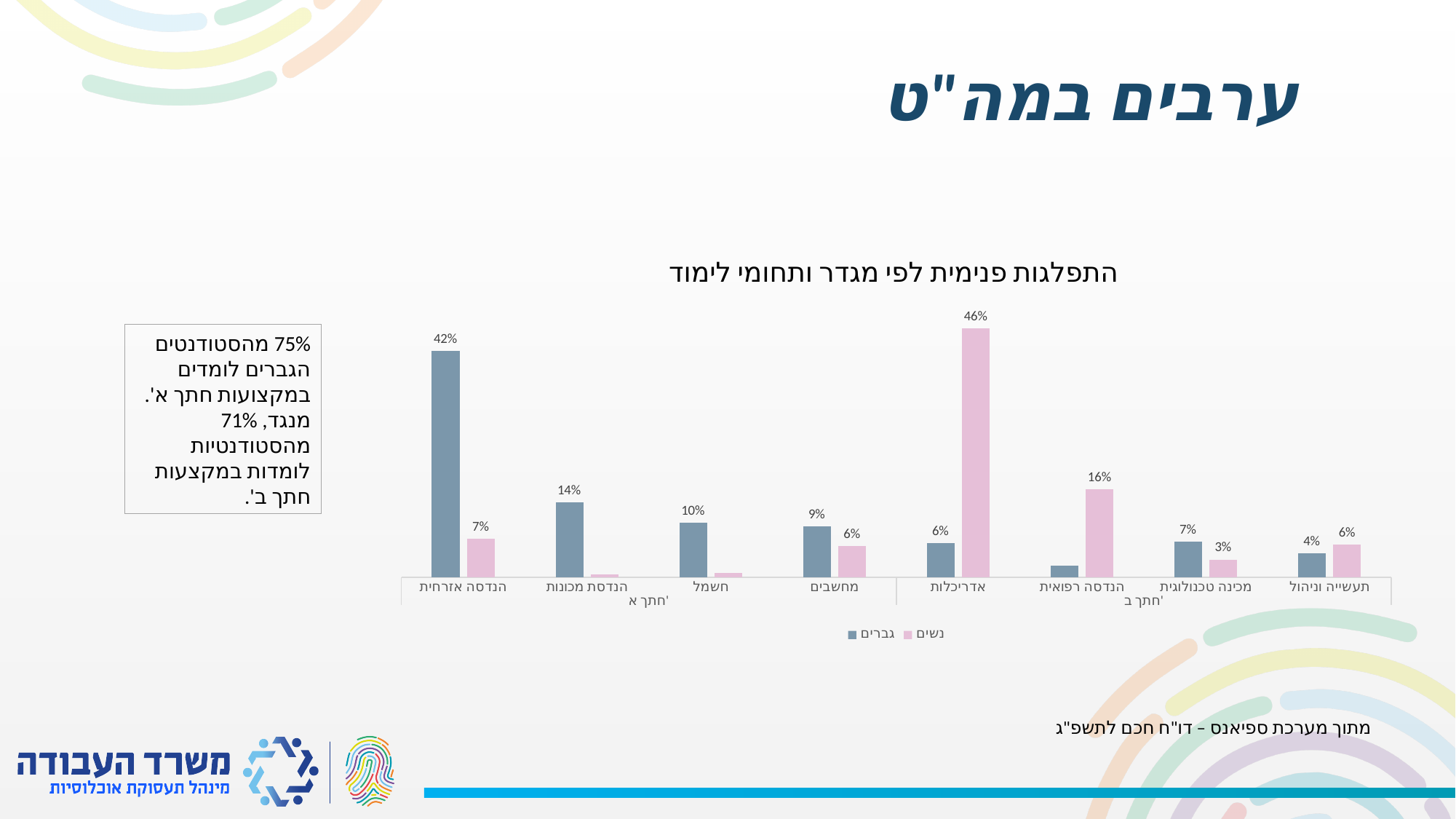
How many study-field categories are shown along the x axis of the chart? 8 In תעשייה וניהול (industrial engineering and management), which is larger: the value for גברים or for נשים? נשים What is the difference between the נשים value in אדריכלות (46%) and the גברים value in אדריכלות (6%)? 40% Which category has the highest value for גברים (men)? הנדסה אזרחית What is the value for נשים (women) in אדריכלות (architecture)? 46% How many series does the chart legend list? 2 What type of chart is shown on the slide? bar chart What is the value for גברים (men) in הנדסה אזרחית (civil engineering)? 42% Which category has the highest value for נשים (women)? אדריכלות What is the difference between the גברים and נשים values in הנדסה אזרחית (civil engineering)? 35% What is the value for נשים (women) in הנדסה רפואית (biomedical engineering)? 16% What are the two series named in the chart legend? גברים and נשים